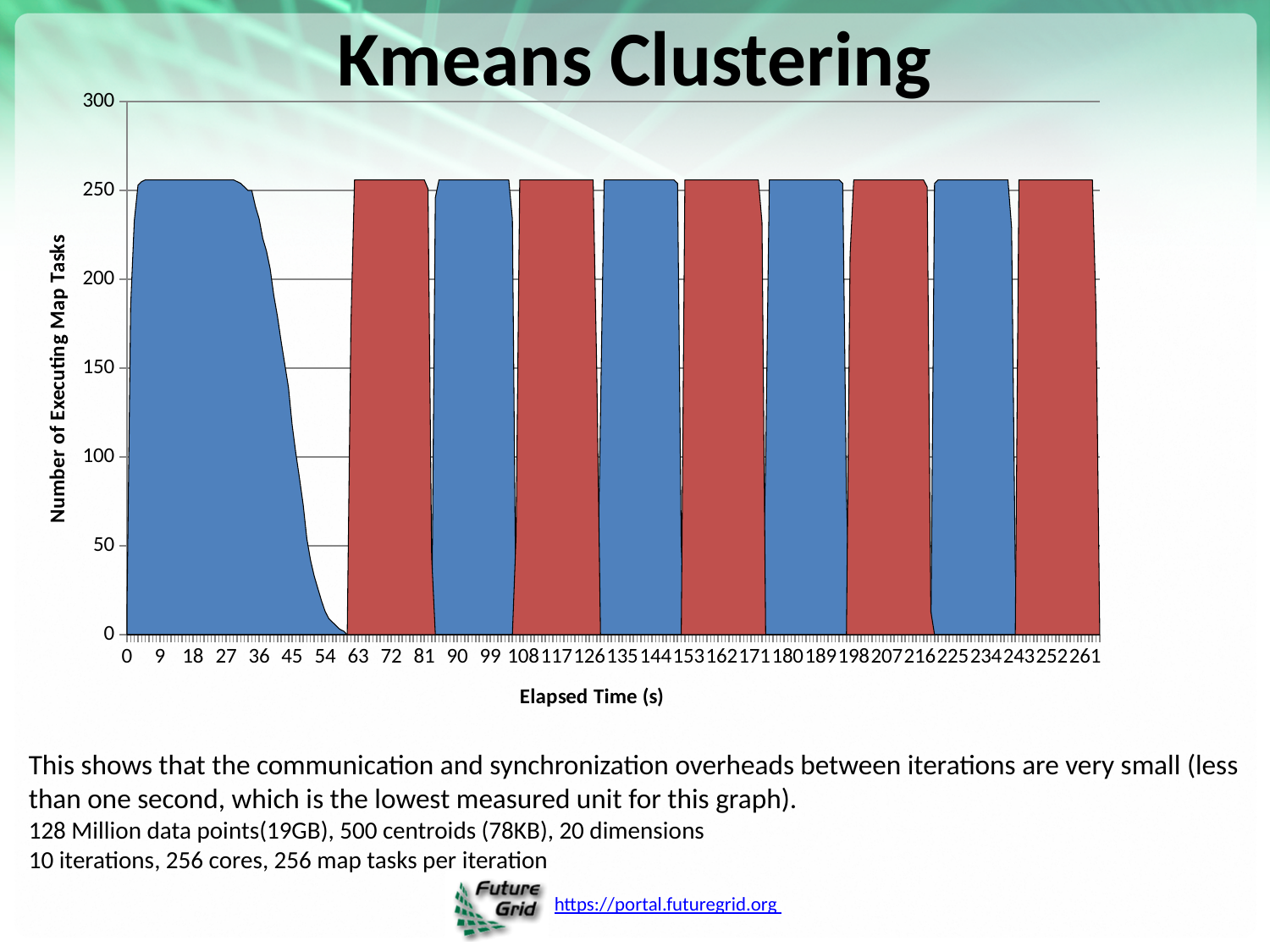
What kind of chart is shown on the slide? area chart Is the number of executing map tasks at 72 s greater or less than 200? greater What is the last tick value shown on the x axis? 261 Between 27 s and 58 s, does the number of executing map tasks rise or fall? fall Is the number of executing map tasks at 9 s greater or less than 150? greater Is the number of executing map tasks at 18 s greater or less than 200? greater What is the highest value shown on the y axis? 300 What is the label of the x axis? Elapsed Time (s) How many separate shaded blocks (iterations) are plotted in the chart? 10 What is the title of the chart? Kmeans Clustering